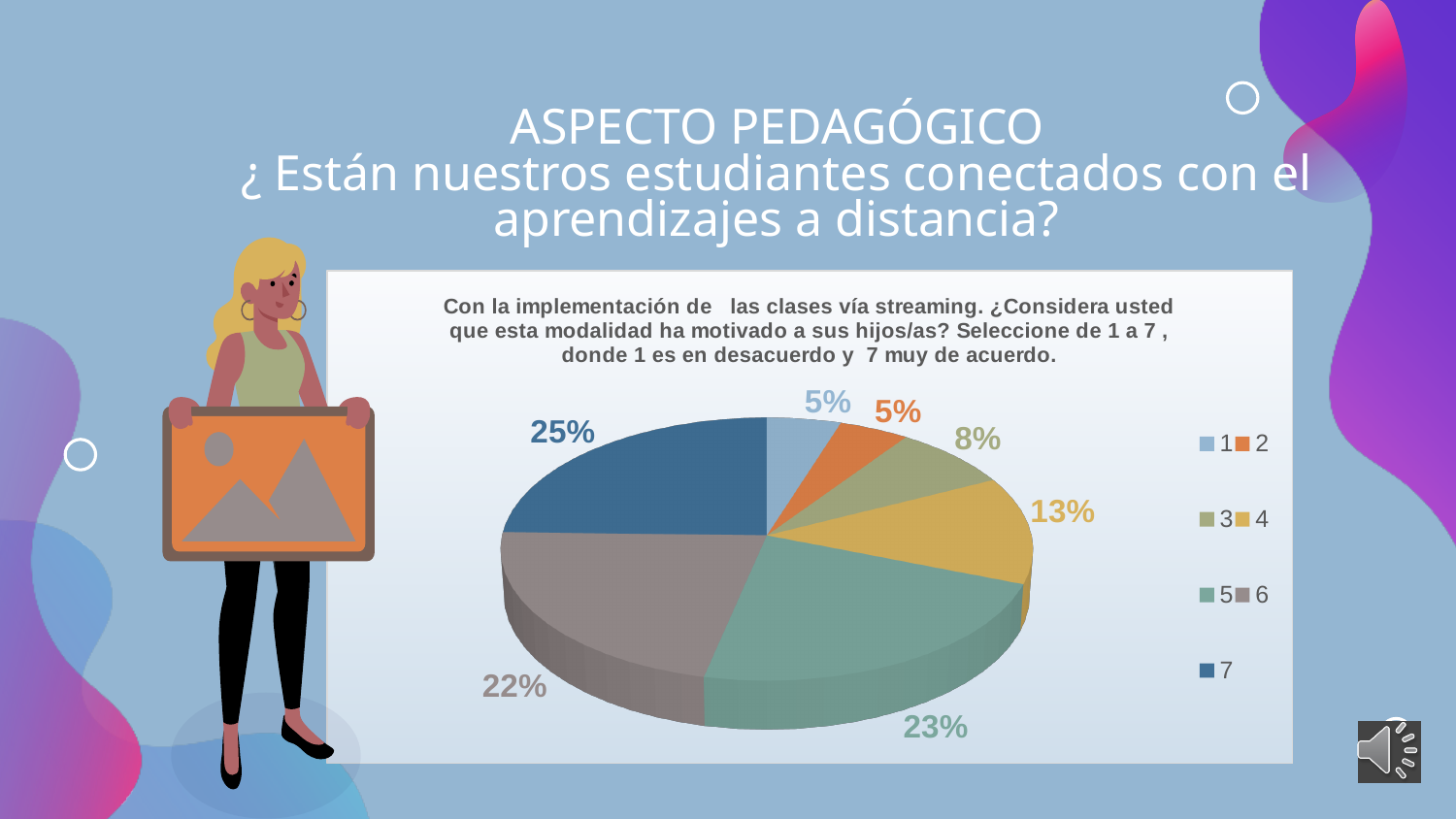
What percentage of respondents selected 3? 8% What is the difference in percentage points between the share for 7 and the share for 6? 3% Which response option has the largest share of the pie? 7 Which has a larger share, response 5 or response 6? 5 How many slices does the pie chart have? 7 What percentage of respondents selected 7 (muy de acuerdo)? 25% What percentage of respondents selected 4? 13% What percentage of respondents selected 5? 23% What percentage of respondents selected 6? 22% How many entries does the legend of the pie chart list? 7 What kind of chart is shown on the slide? pie chart What is the combined share of responses 5, 6 and 7? 70%